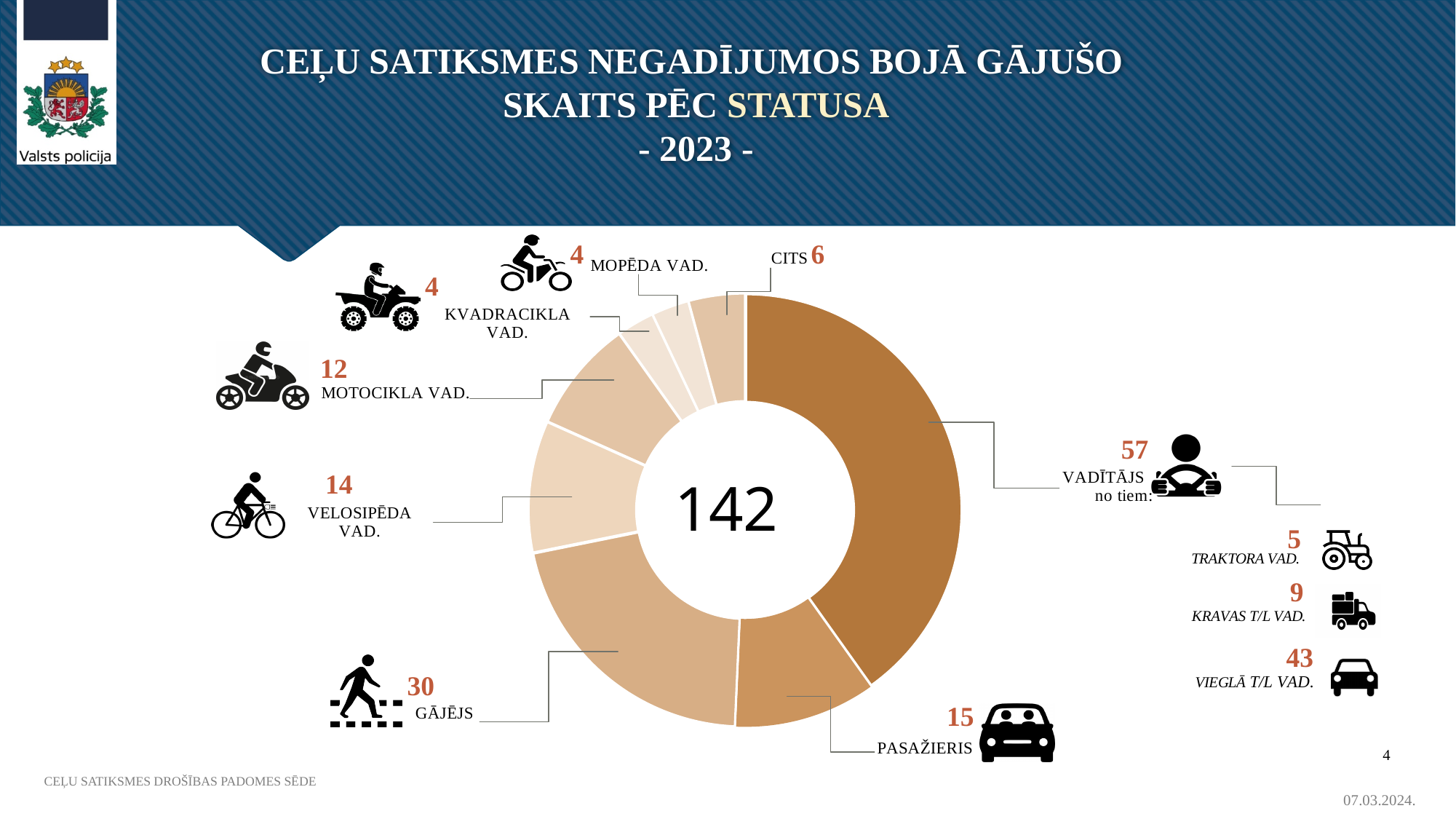
What is the difference between the values for PASAŽIERIS and MOTOCIKLA VAD.? 3 What is the value for VELOSIPĒDA VAD. in the donut chart? 14 What kind of chart is shown on the slide? Donut (pie) chart What is the total shown in the centre of the donut chart? 142 What is the value for CITS in the donut chart? 6 How many categories (slices) does the donut chart have? 8 Which is larger, the value for VELOSIPĒDA VAD. or the value for MOTOCIKLA VAD.? VELOSIPĒDA VAD. What is the difference between the values for VADĪTĀJS and GĀJĒJS? 27 Which category has the highest value in the donut chart? VADĪTĀJS What is the value for PASAŽIERIS in the donut chart? 15 What is the value for GĀJĒJS in the donut chart? 30 Of the 57 VADĪTĀJS, how many are VIEGLĀ T/L VAD.? 43